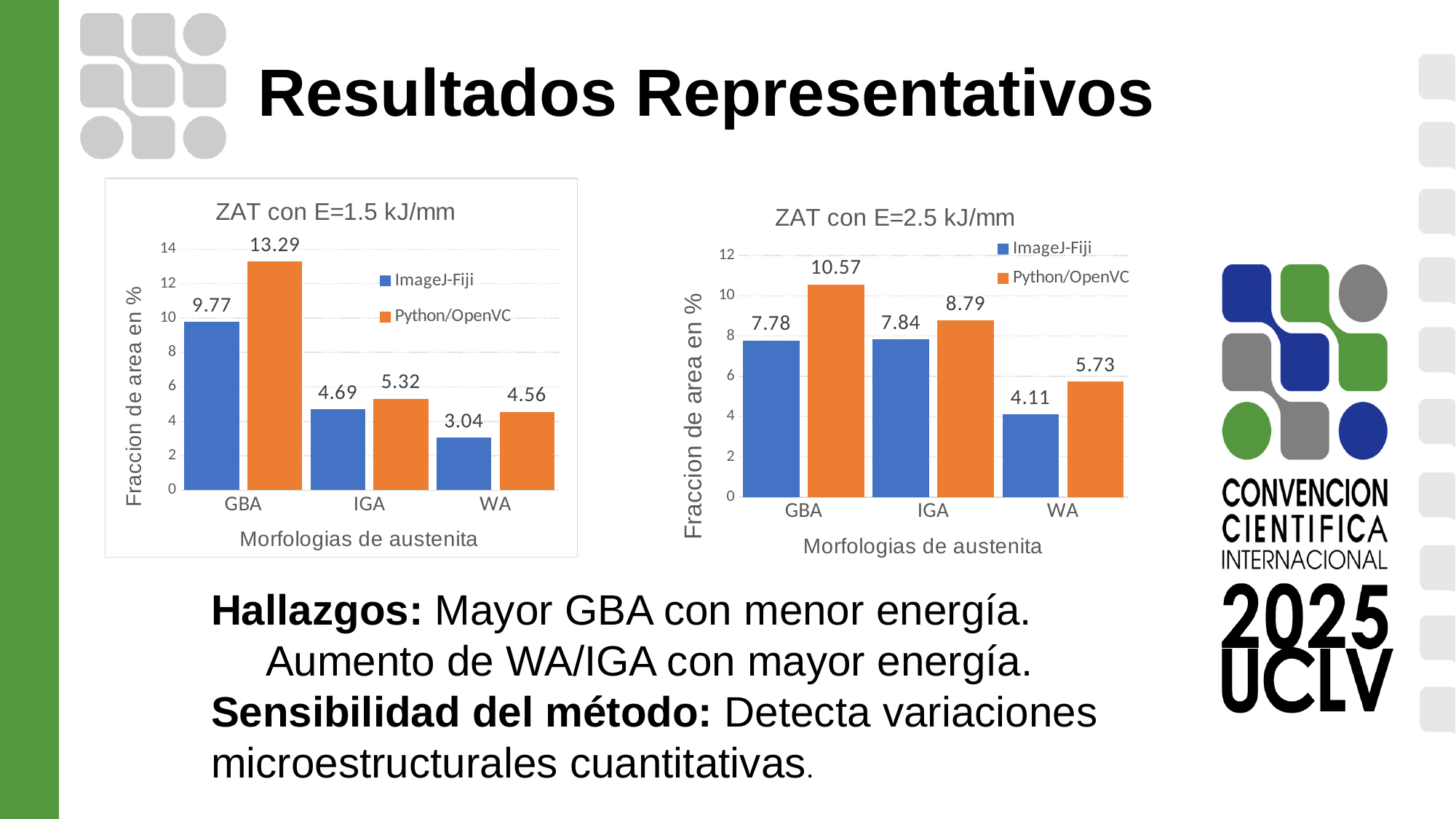
In the chart titled 'ZAT con E=1.5 kJ/mm', which category has the highest ImageJ-Fiji value? GBA In the chart titled 'ZAT con E=1.5 kJ/mm', what is the value for Python/OpenVC at GBA? 13.29 In the chart titled 'ZAT con E=2.5 kJ/mm', what is the value for Python/OpenVC at IGA? 8.79 In the chart titled 'ZAT con E=1.5 kJ/mm', what is the value for ImageJ-Fiji at WA? 3.04 In the chart titled 'ZAT con E=2.5 kJ/mm', which category has the lowest Python/OpenVC value? WA How many categories are shown on the x axis of the chart titled 'ZAT con E=1.5 kJ/mm'? 3 In the chart titled 'ZAT con E=1.5 kJ/mm', what is the difference between the Python/OpenVC and ImageJ-Fiji values at GBA? 3.52 In the chart titled 'ZAT con E=2.5 kJ/mm', what is the difference between the Python/OpenVC and ImageJ-Fiji values at WA? 1.62 In the chart titled 'ZAT con E=2.5 kJ/mm', which is larger at GBA: the ImageJ-Fiji value or the Python/OpenVC value? Python/OpenVC How many series does the legend list in the chart titled 'ZAT con E=2.5 kJ/mm'? 2 In the chart titled 'ZAT con E=2.5 kJ/mm', what is the value for ImageJ-Fiji at GBA? 7.78 What kind of chart is the chart titled 'ZAT con E=1.5 kJ/mm'? Bar chart